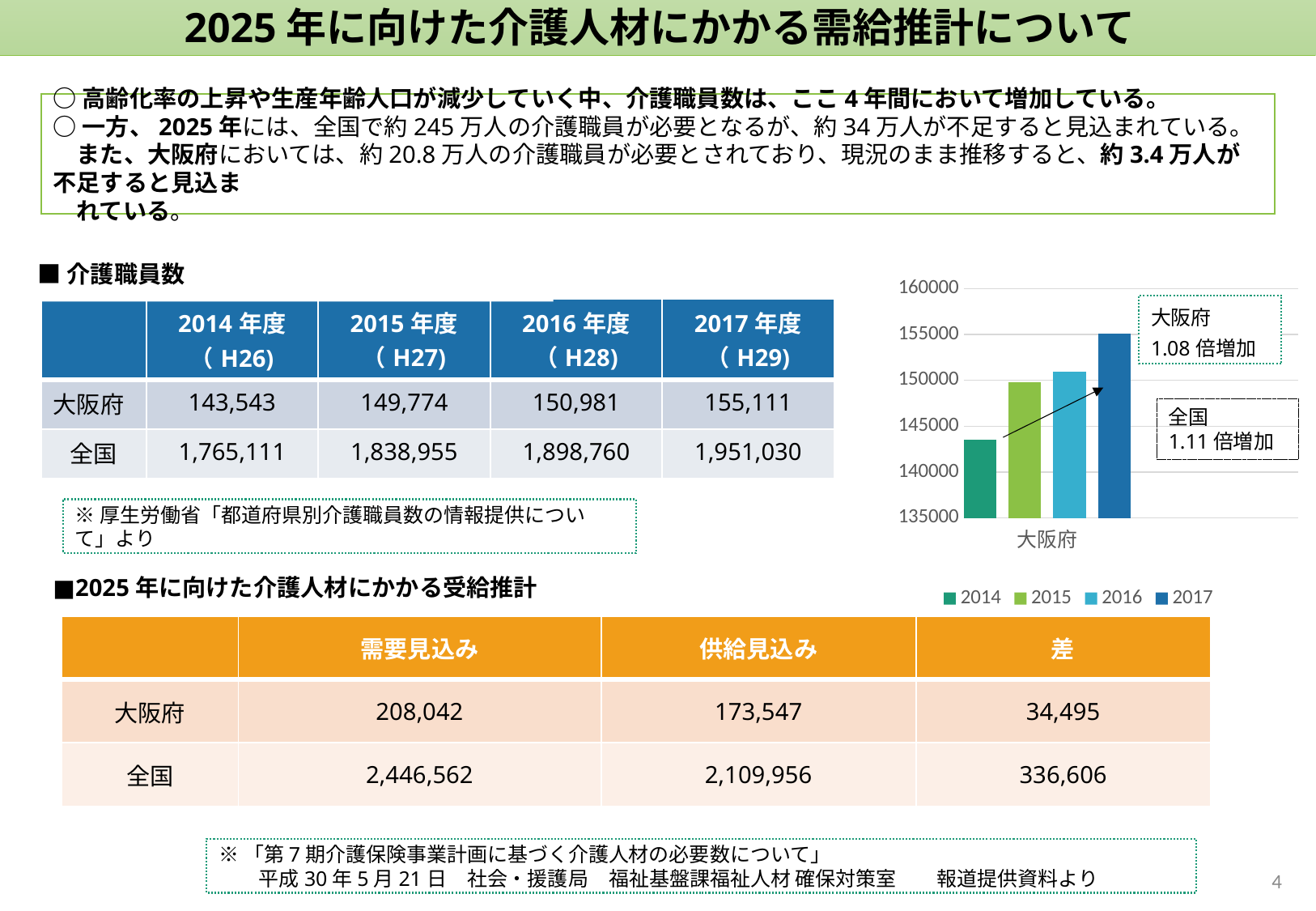
What kind of chart is shown on the right side of the slide? bar chart How many series does the legend of the bar chart list? 4 Which year has the shortest bar in the bar chart? 2014 According to the annotation box next to the chart, by what factor did the 大阪府 figure increase? 1.08 倍増加 Do the bars in the chart rise or fall from 2014 to 2017? rise What category label appears under the bars on the x axis of the chart? 大阪府 Which year has the tallest bar in the bar chart? 2017 Is the value of the 2017 bar greater or less than 150000? greater Is the value of the 2014 bar greater or less than 145000? less Which bar is taller in the chart, 2014 or 2017? 2017 How many bars are plotted in the bar chart? 4 Is the value of the 2016 bar greater or less than 145000? greater